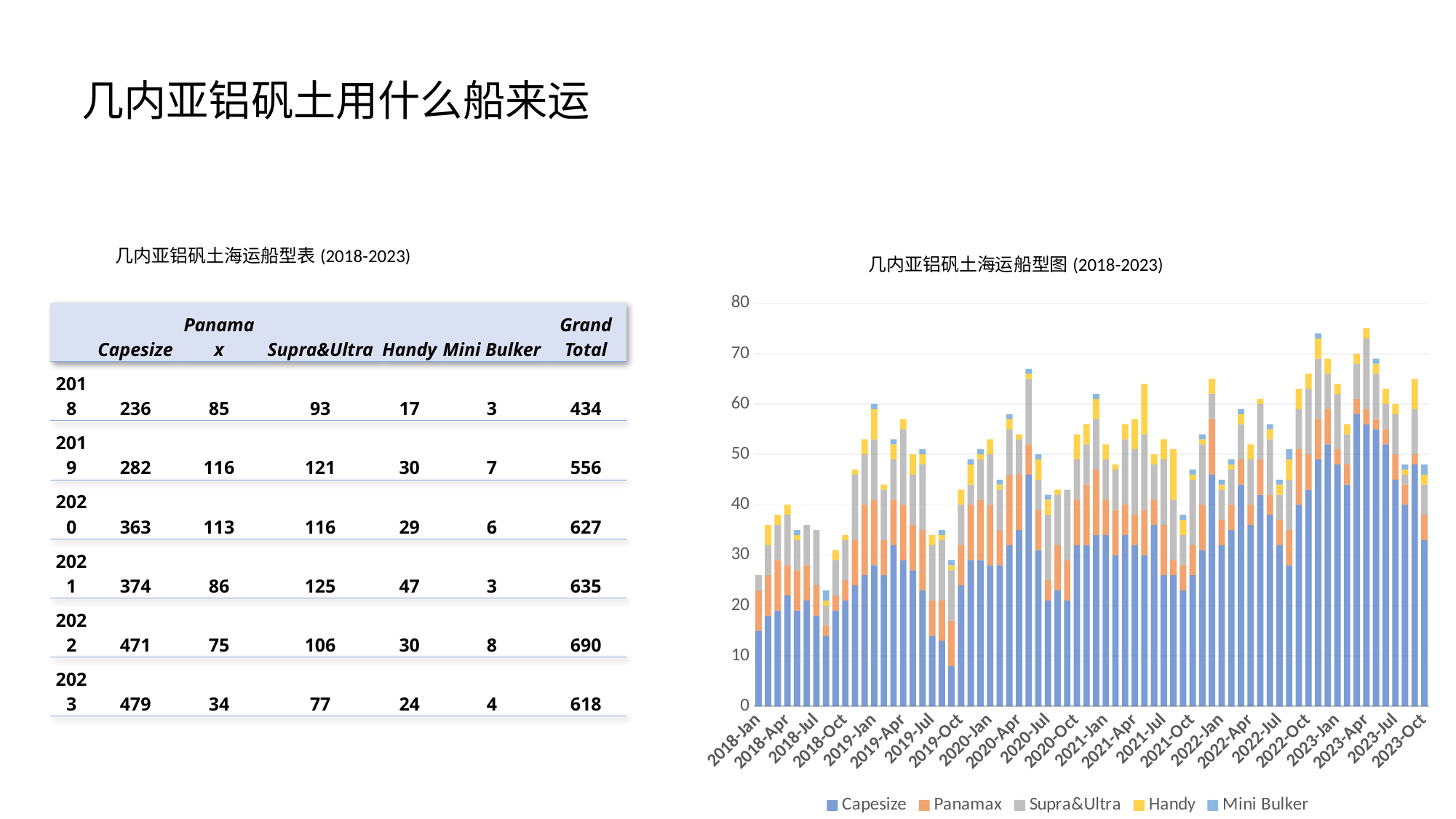
Is the total value of the bar for 2022-Oct greater or less than 70? less Overall, do the bar totals rise or fall from 2018 to 2023 along the x axis? rise Is the Capesize segment of the bar for 2023-Apr greater or less than 50? greater What kind of chart is shown on the right side of the slide? Stacked bar chart Is the total value of the bar for 2018-Jan greater or less than 30? less Which series is shown in yellow in the chart? Handy Which bar is taller, 2023-Apr or 2018-Jan? 2023-Apr How many series does the legend of the chart list? 5 What is the title of the chart on the right? 几内亚铝矾土海运船型图 (2018-2023) Which has the larger Capesize segment, 2018-Jan or 2023-Apr? 2023-Apr